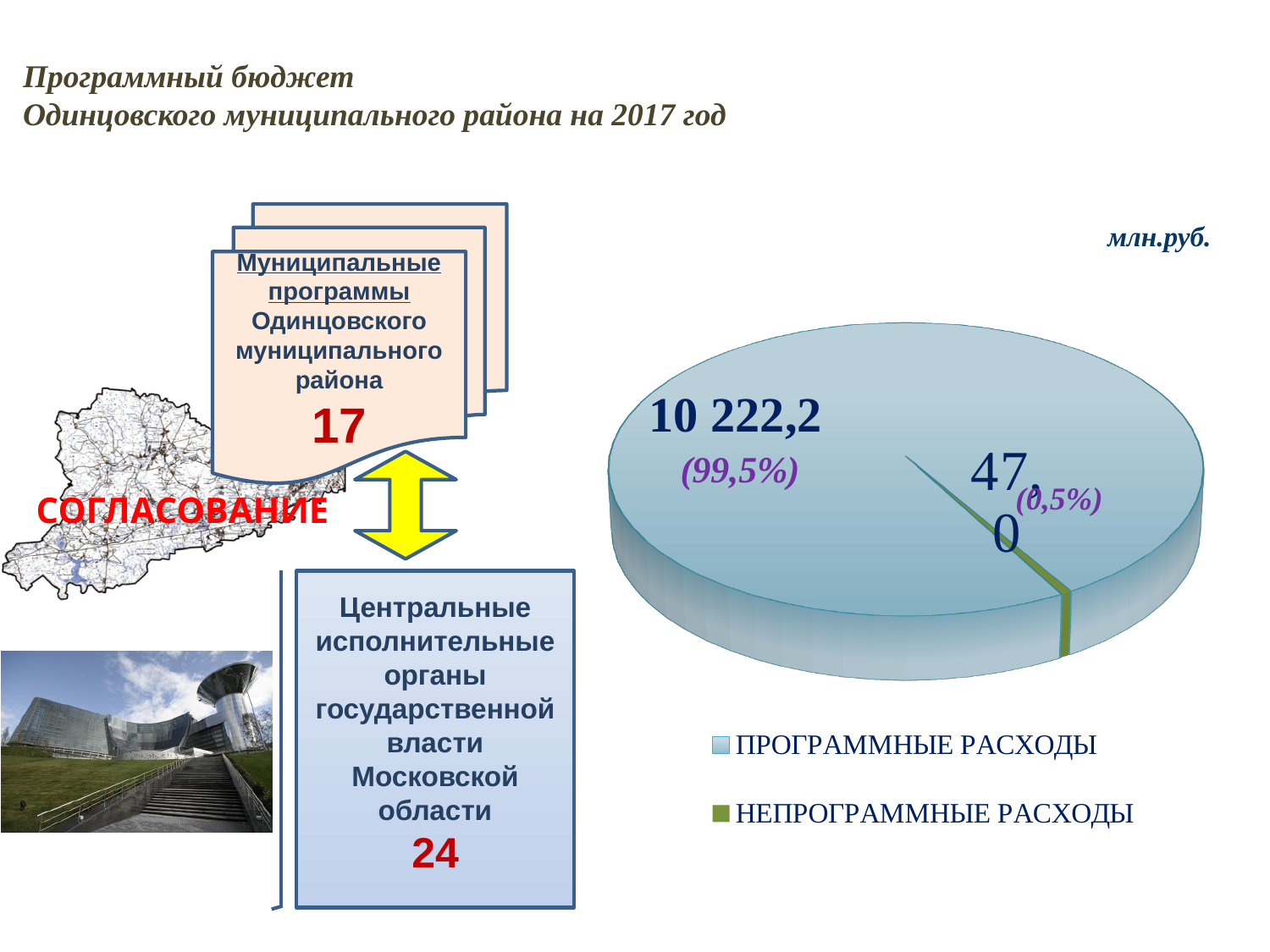
What share of the pie does НЕПРОГРАММНЫЕ РАСХОДЫ represent? 0,5% What is the value for ПРОГРАММНЫЕ РАСХОДЫ in the pie chart? 10 222,2 How many slices does the pie chart have? 2 What is the value for НЕПРОГРАММНЫЕ РАСХОДЫ in the pie chart? 47,0 How many entries does the legend of the pie chart list? 2 What kind of chart is shown on the slide? pie chart What share of the pie does ПРОГРАММНЫЕ РАСХОДЫ represent? 99,5% Which is larger in the pie chart, ПРОГРАММНЫЕ РАСХОДЫ or НЕПРОГРАММНЫЕ РАСХОДЫ? ПРОГРАММНЫЕ РАСХОДЫ Which slice of the pie chart is the smallest? НЕПРОГРАММНЫЕ РАСХОДЫ Which slice of the pie chart is the largest? ПРОГРАММНЫЕ РАСХОДЫ What unit is indicated for the values in the pie chart? млн.руб. What colour is the НЕПРОГРАММНЫЕ РАСХОДЫ slice in the pie chart legend? green